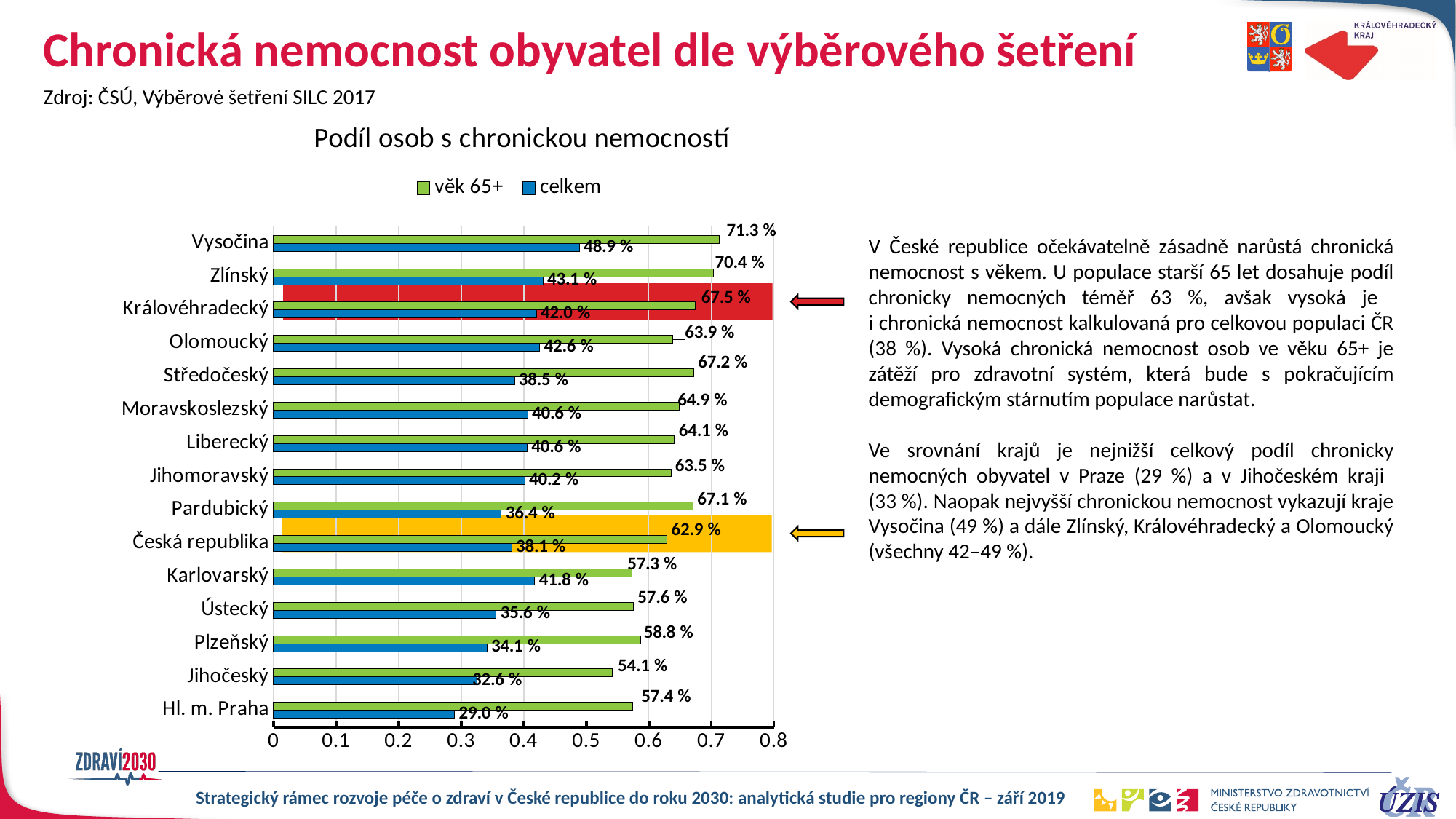
Which category has the highest 'věk 65+' value? Vysočina What is the value of 'věk 65+' for Vysočina? 71.3 % What is the difference between the 'věk 65+' and 'celkem' values for Vysočina? 22.4 % How many categories (regions, including Česká republika) are shown on the chart? 15 Which is larger: the 'celkem' value for Karlovarský or the 'celkem' value for Ústecký? Karlovarský What is the value of 'celkem' for Hl. m. Praha? 29.0 % Which category has the lowest 'věk 65+' value? Jihočeský What type of chart is shown on the slide? bar chart Which category has the lowest 'celkem' value? Hl. m. Praha What is the value of 'celkem' for Česká republika? 38.1 % How many series does the chart legend list? 2 What is the title of the chart? Podíl osob s chronickou nemocností